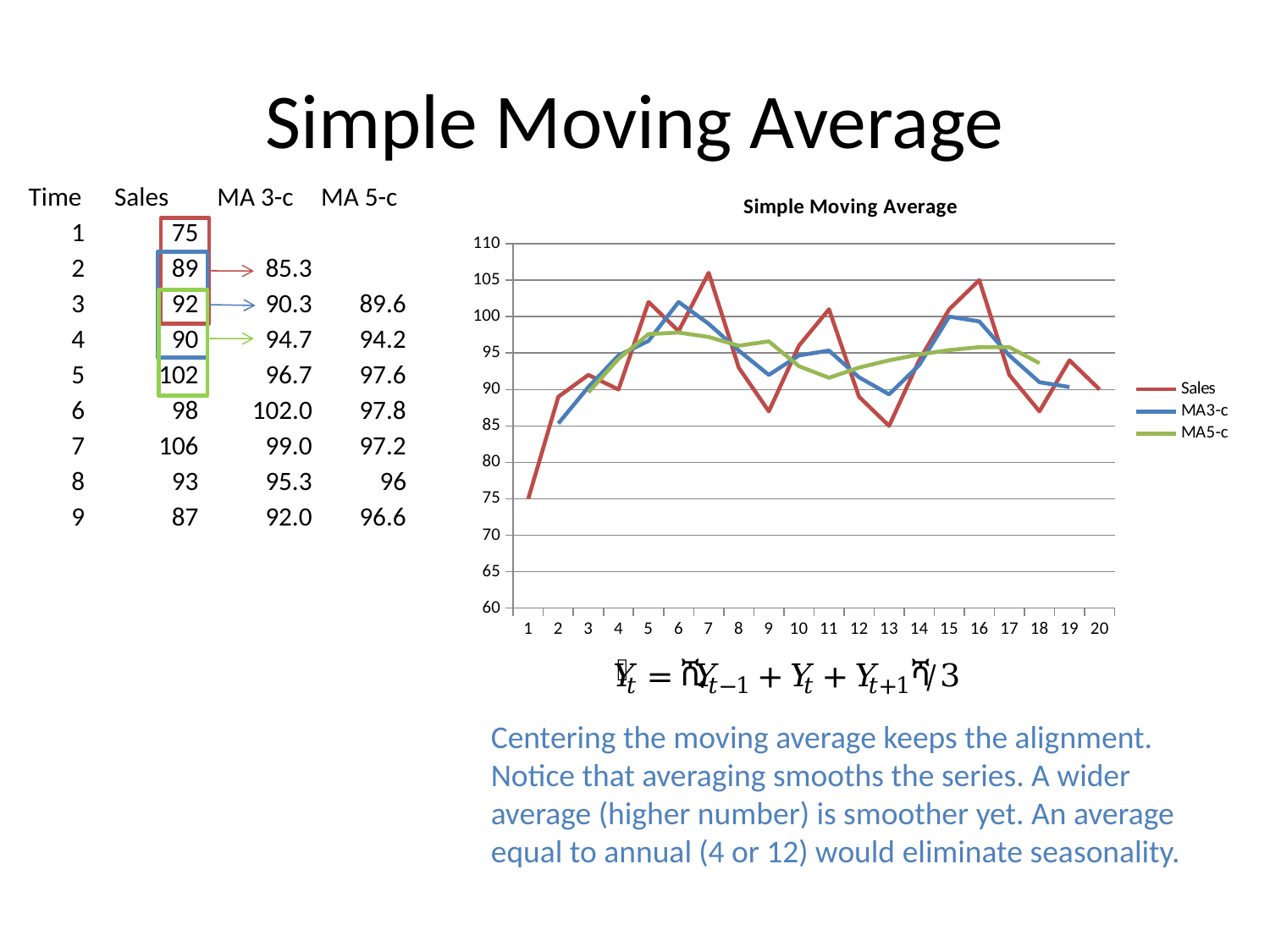
Is the Sales value at time 7 greater or less than 105? greater Is the Sales value at time 13 greater or less than 90? less Which colour is used for the Sales series in the chart? red At time 6, which series has the higher value, MA3-c or MA5-c? MA3-c How many time points are shown along the x axis of the chart? 20 Does the Sales series rise or fall from time 1 to time 7? rise What is the Sales value at time 1? 75 At which time point is the Sales series at its lowest value? 1 How many series does the chart legend list? 3 What is the title of the chart? Simple Moving Average Is the MA3-c value at time 2 greater or less than 90? less What kind of chart is shown on the slide? line chart